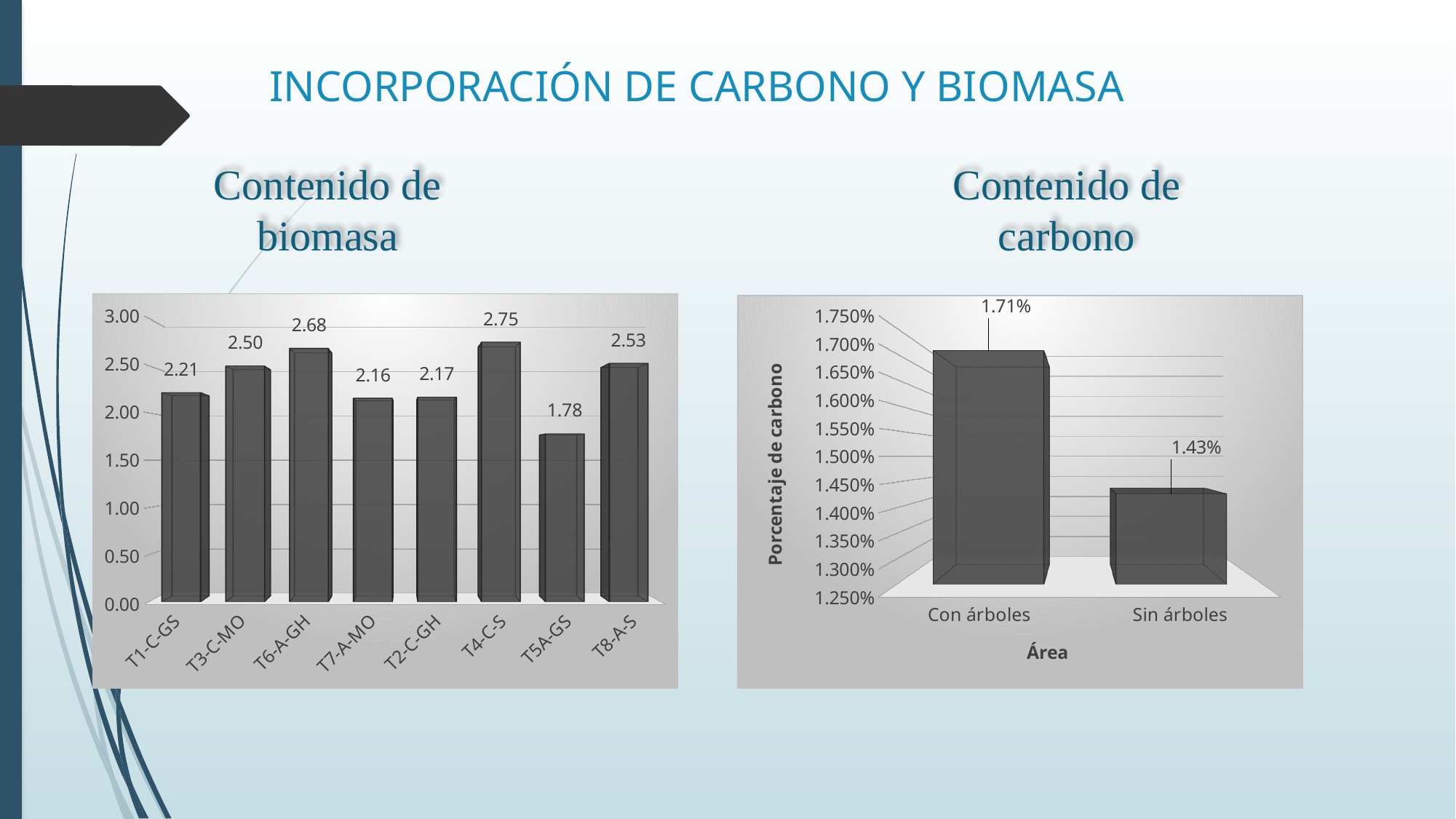
In the 'Contenido de biomasa' chart, what is the difference between the values for T4-C-S and T5A-GS? 0.97 In the 'Contenido de carbono' chart, what is the value for Con árboles? 1.71% What kind of chart is the 'Contenido de biomasa' chart? Bar chart In the 'Contenido de carbono' chart, what is the label of the vertical axis? Porcentaje de carbono In the 'Contenido de biomasa' chart, which category has the highest value? T4-C-S In the 'Contenido de carbono' chart, what is the value for Sin árboles? 1.43% In the 'Contenido de biomasa' chart, which is larger, the value for T3-C-MO or the value for T8-A-S? T8-A-S In the 'Contenido de biomasa' chart, what is the value for T5A-GS? 1.78 In the 'Contenido de carbono' chart, what is the difference between the values for Con árboles and Sin árboles? 0.28% In the 'Contenido de biomasa' chart, what is the value for T6-A-GH? 2.68 In the 'Contenido de biomasa' chart, which category has the lowest value? T5A-GS How many categories are shown in the 'Contenido de biomasa' chart? 8